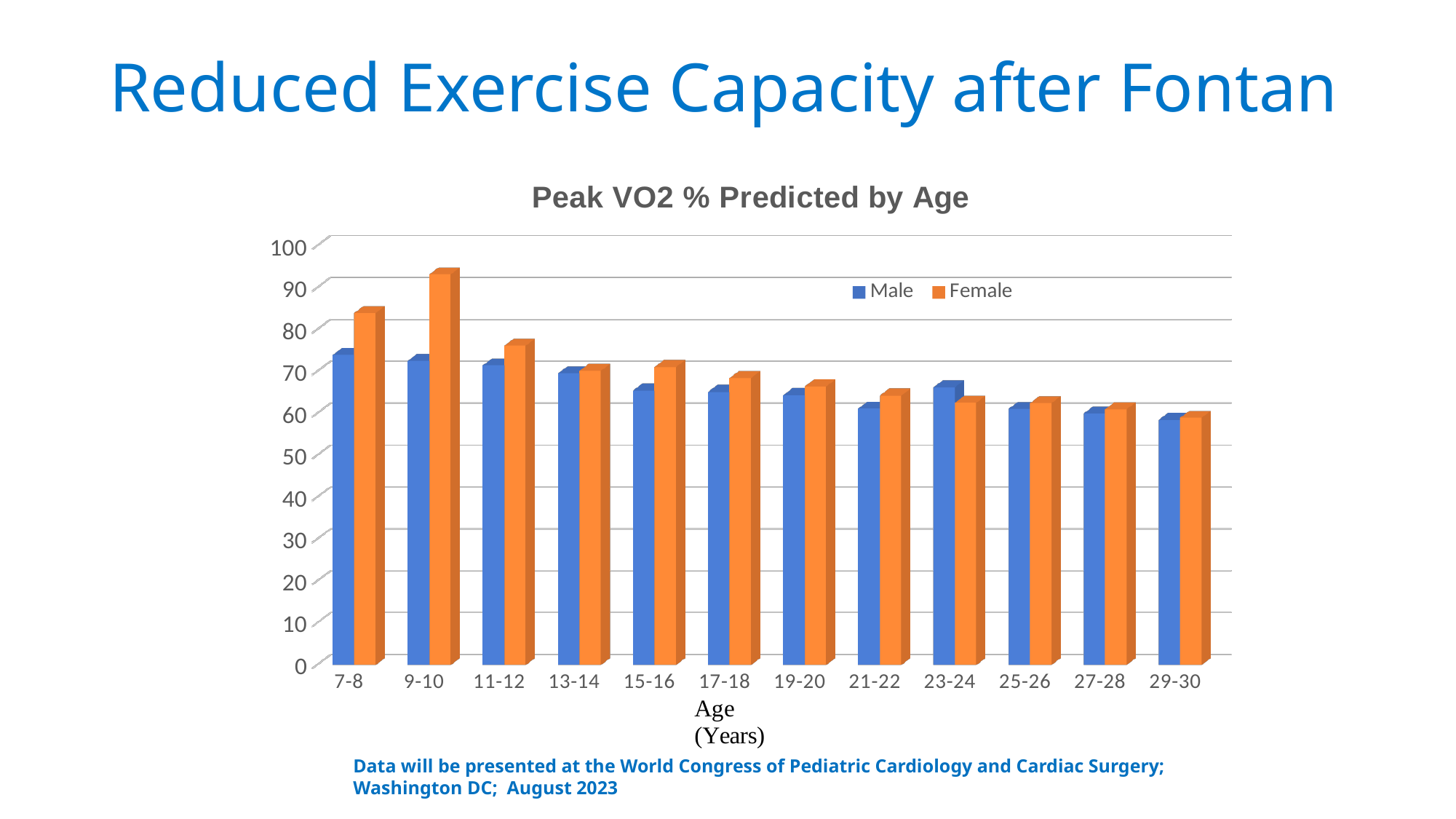
Which age group has the highest Female value? 9-10 For the 7-8 age group, which is larger, the Male or the Female value? Female Is the Female value for the 9-10 age group greater or less than 90? greater Is the Male value for the 15-16 age group greater or less than 70? less What kind of chart is shown on the slide? bar chart How many series does the chart's legend list? 2 Do the Female values generally rise or fall as age increases along the x axis? fall What is the title of the chart? Peak VO2 % Predicted by Age For the 23-24 age group, which is larger, the Male or the Female value? Male Is the Female value for the 7-8 age group greater or less than 80? greater How many age groups are shown on the x axis of the chart? 12